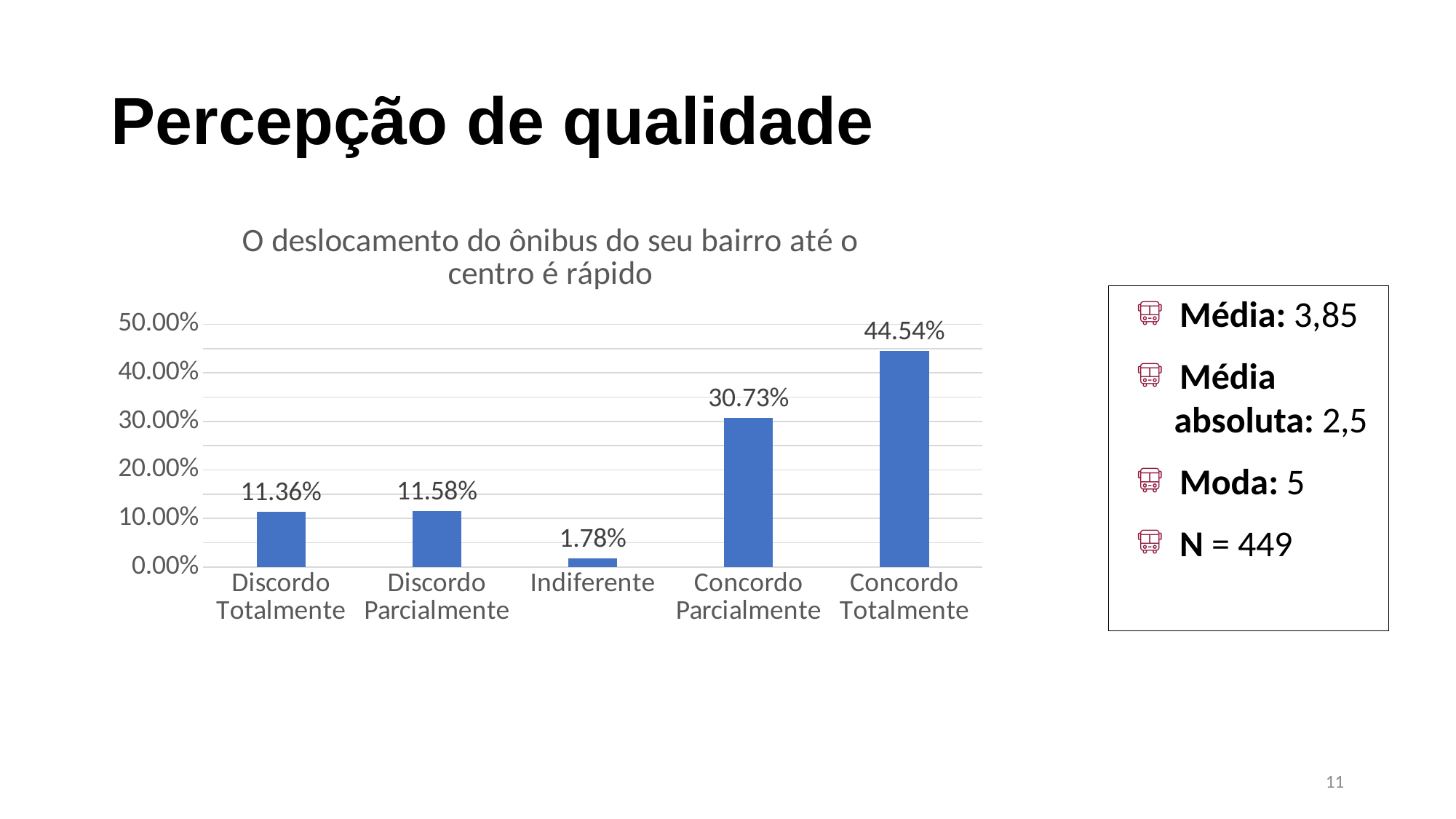
Which category has the lowest value? Indiferente What type of chart is shown on the slide? bar chart What is the value for Concordo Totalmente? 44.54% What is the value for Discordo Totalmente? 11.36% What is the value for Indiferente? 1.78% Which is larger, the value for Discordo Parcialmente or the value for Concordo Parcialmente? Concordo Parcialmente What is the difference between the values for Concordo Totalmente and Concordo Parcialmente? 13.81% What is the value for Concordo Parcialmente? 30.73% Which category has the highest value? Concordo Totalmente What is the title of the chart? O deslocamento do ônibus do seu bairro até o centro é rápido Is the value for Concordo Parcialmente greater or less than 20.00%? greater How many categories are shown on the x axis of the chart? 5